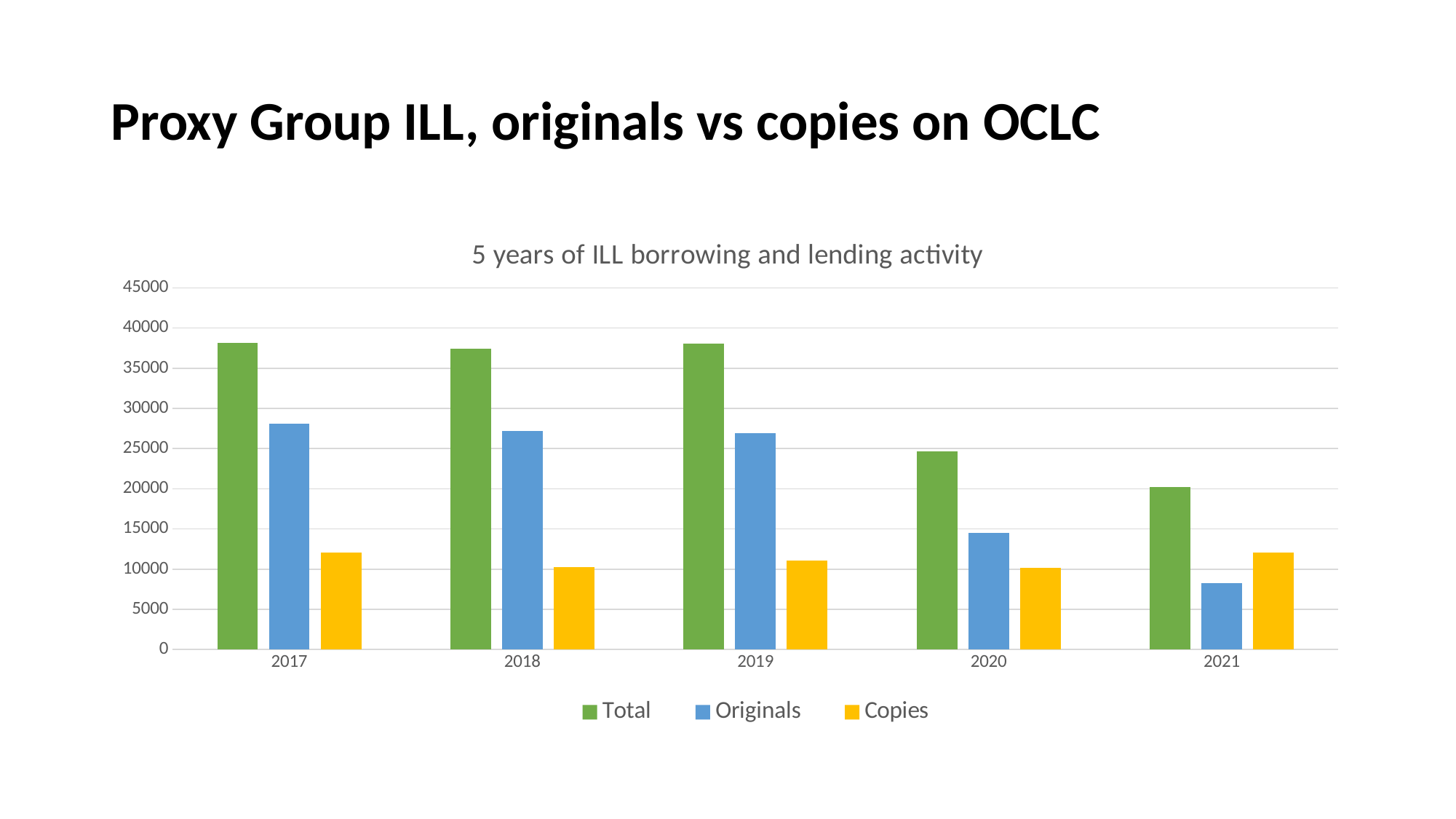
Which is larger in 2017, Originals or Copies? Originals Is the Originals value for 2021 greater or less than 10000? less What kind of chart is shown on the slide? bar chart Do the Originals values rise or fall from 2017 to 2021? fall How many years are shown on the x axis? 5 Is the Total value for 2020 greater or less than 20000? greater Which series is shown in yellow? Copies Is the Total value for 2017 greater or less than 40000? less How many series does the legend list? 3 In which year is the Originals value lowest? 2021 In which year is the Total value lowest? 2021 What is the title of the chart? 5 years of ILL borrowing and lending activity